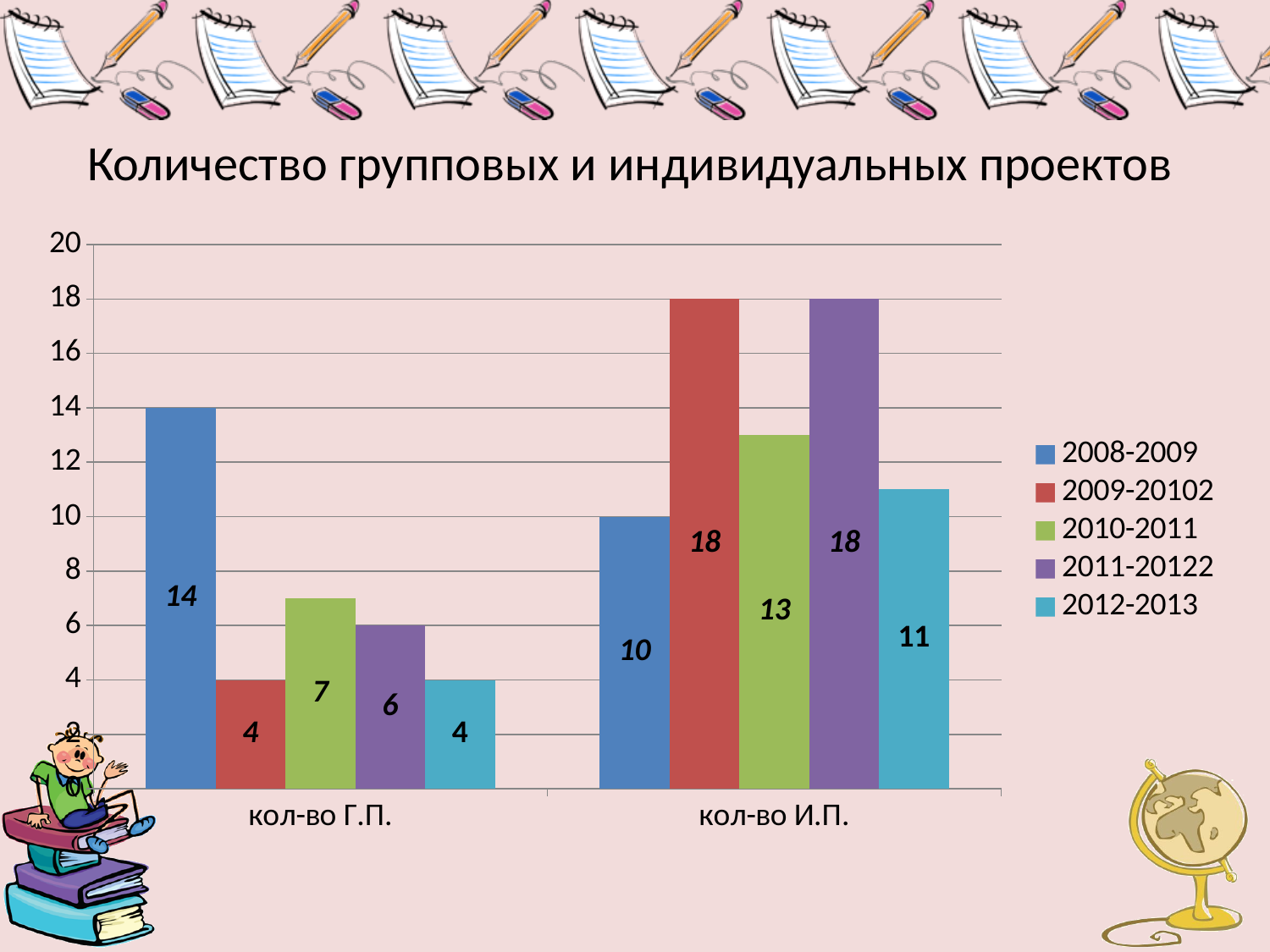
What is the value for 2010-2011 in the кол-во И.П. category? 13 What is the difference between the 2009-20102 values for кол-во И.П. and кол-во Г.П.? 14 How many series does the legend list? 5 Which series has the lowest value in the кол-во И.П. category? 2008-2009 Which series has the highest value in the кол-во Г.П. category? 2008-2009 What kind of chart is shown on the slide? bar chart How many categories are shown on the x axis? 2 What is the value for 2012-2013 in the кол-во И.П. category? 11 Which is larger: the 2010-2011 value for кол-во Г.П. or the 2012-2013 value for кол-во Г.П.? 2010-2011 What is the value for 2011-20122 in the кол-во Г.П. category? 6 What is the value for 2008-2009 in the кол-во Г.П. category? 14 What is the title of the chart? Количество групповых и индивидуальных проектов